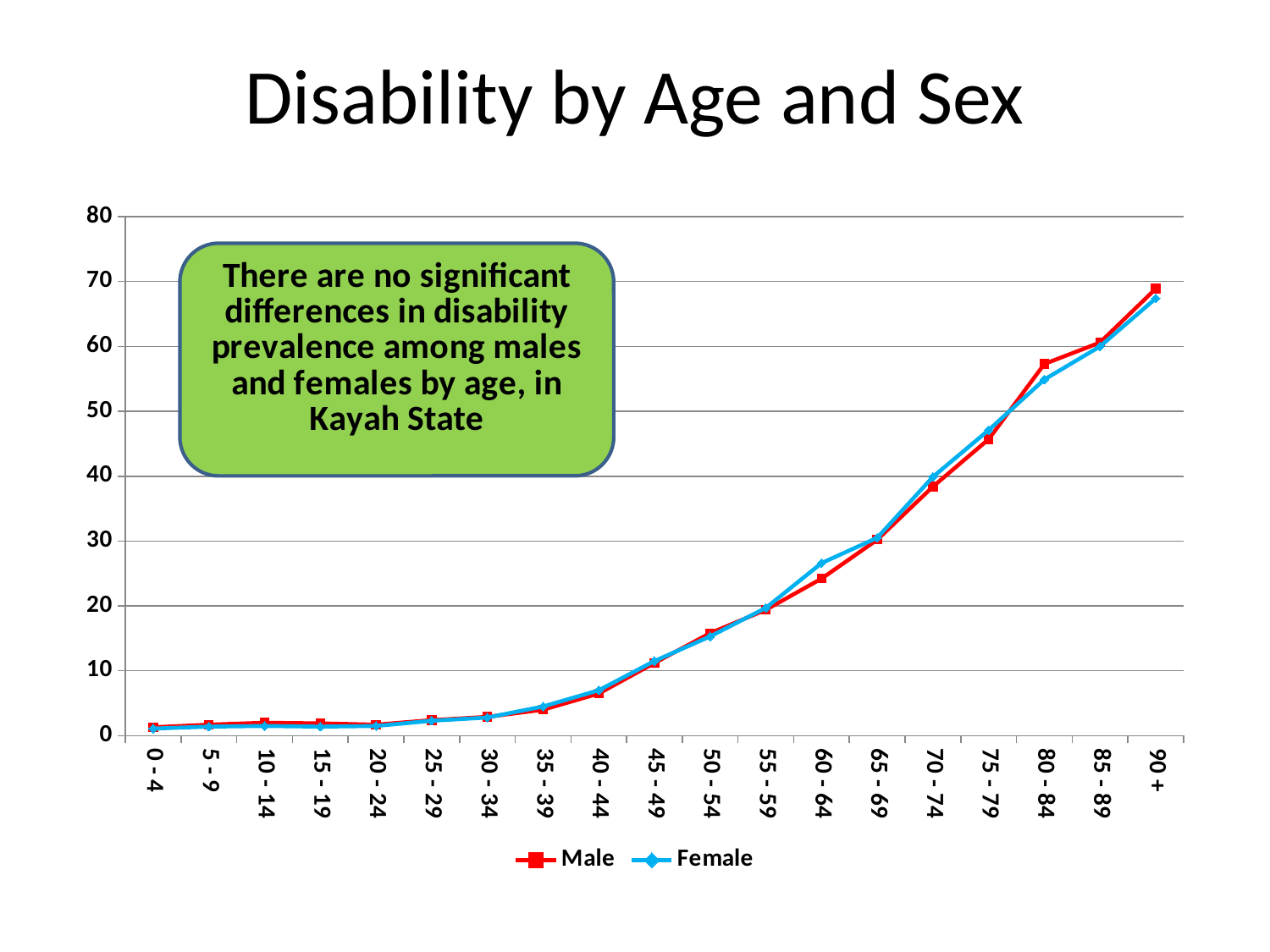
Is the value for Female at 70 - 74 greater or less than 50? less At age group 60 - 64, which series has the larger value, Male or Female? Female Is the value for Male at 55 - 59 greater or less than 30? less What kind of chart is shown on the slide? line chart How many age groups are shown on the x axis? 19 Which age group has the highest value for Female? 90 + Is the value for Male at 90 + greater or less than 60? greater What is the title of the slide's chart? Disability by Age and Sex Do the Male values generally rise or fall as age increases along the x axis? rise Which age group has the highest value for Male? 90 + How many series does the legend list? 2